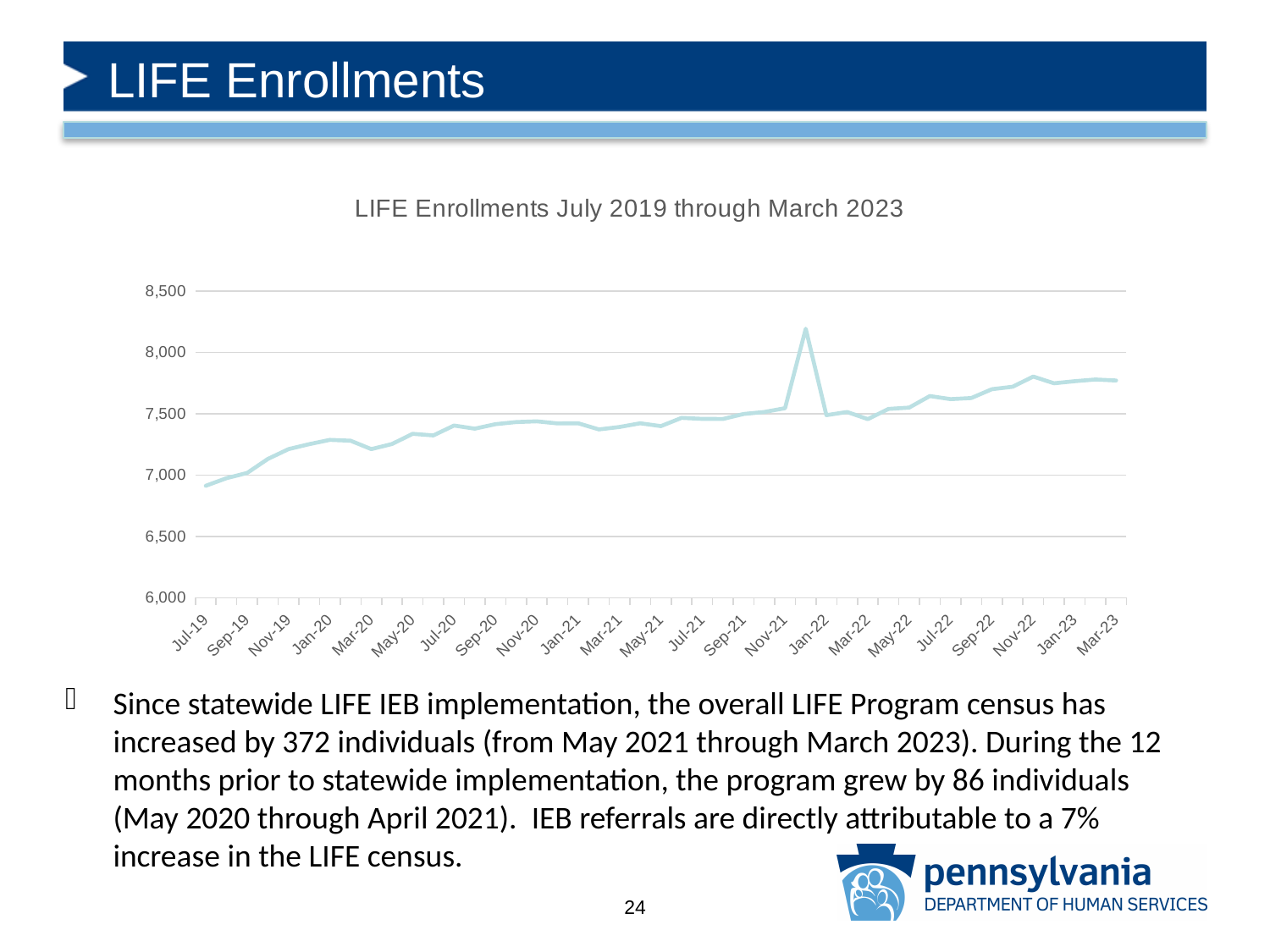
Is the value for Mar-23 greater or less than 7,500? greater Is the value for Jan-21 greater or less than 7,500? less What is the title of the chart? LIFE Enrollments July 2019 through March 2023 Which is larger, the value for Jul-22 or the value for Jan-21? Jul-22 Which labeled month has the lowest enrollment value? Jul-19 Is the highest point on the line greater or less than 8,000? greater Which is larger, the value for Mar-23 or the value for Jul-19? Mar-23 What kind of chart is shown on the slide? Line chart Between which two labeled months does the sharp spike in enrollments occur? Nov-21 and Jan-22 Overall, do LIFE enrollments rise or fall from Jul-19 to Mar-23? Rise